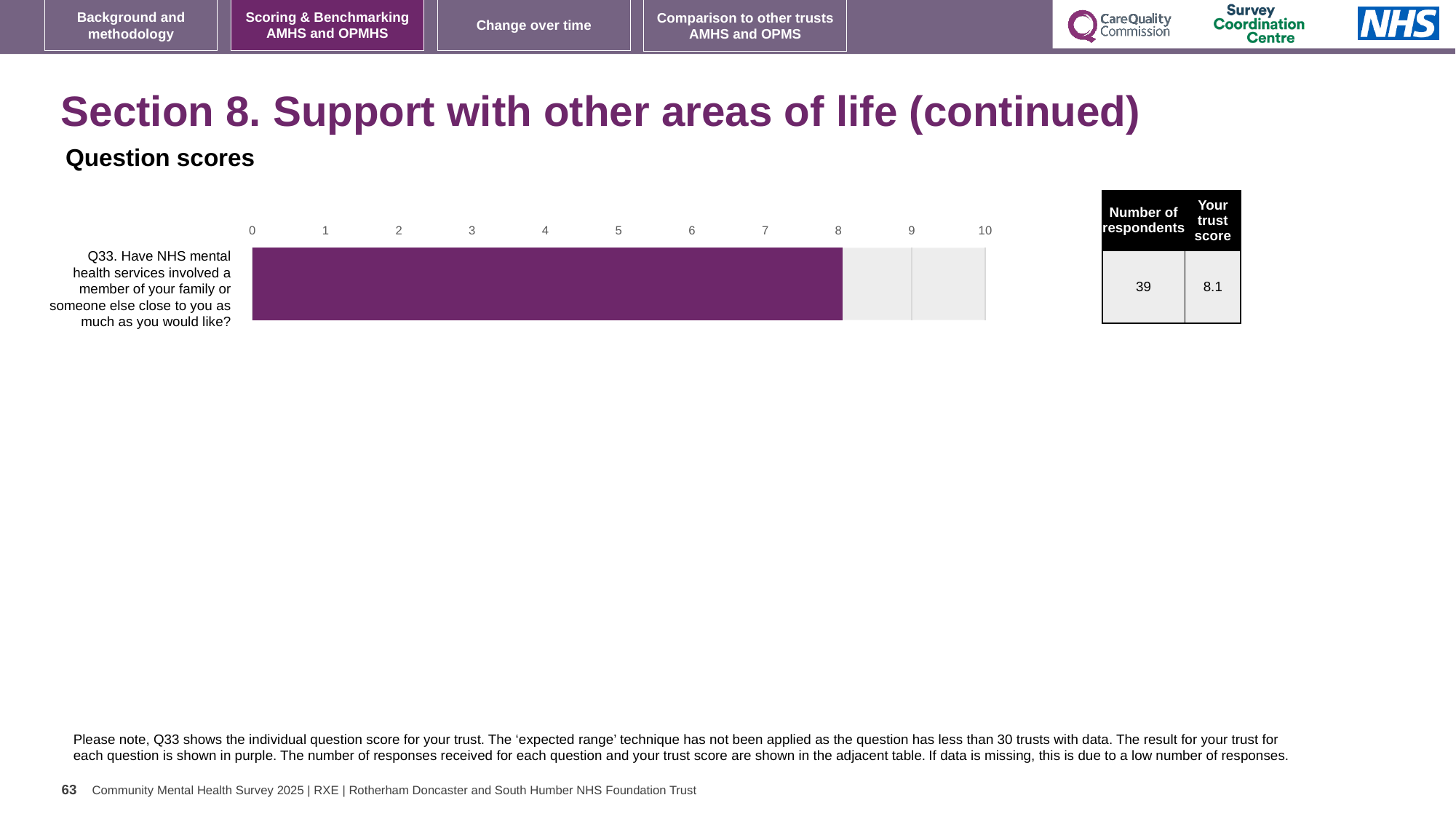
What is the trust score for Q33 shown in the table next to the chart? 8.1 How many respondents answered Q33 according to the table? 39 Is the value for Q33 greater or less than 7? greater What is the maximum value shown on the chart's horizontal axis? 10 What colour is the bar for Q33? Purple Is the value for Q33 greater or less than 10? less What kind of chart is shown on the slide? Bar chart Is the value for Q33 greater or less than 5? greater How many questions (categories) are plotted on the chart? 1